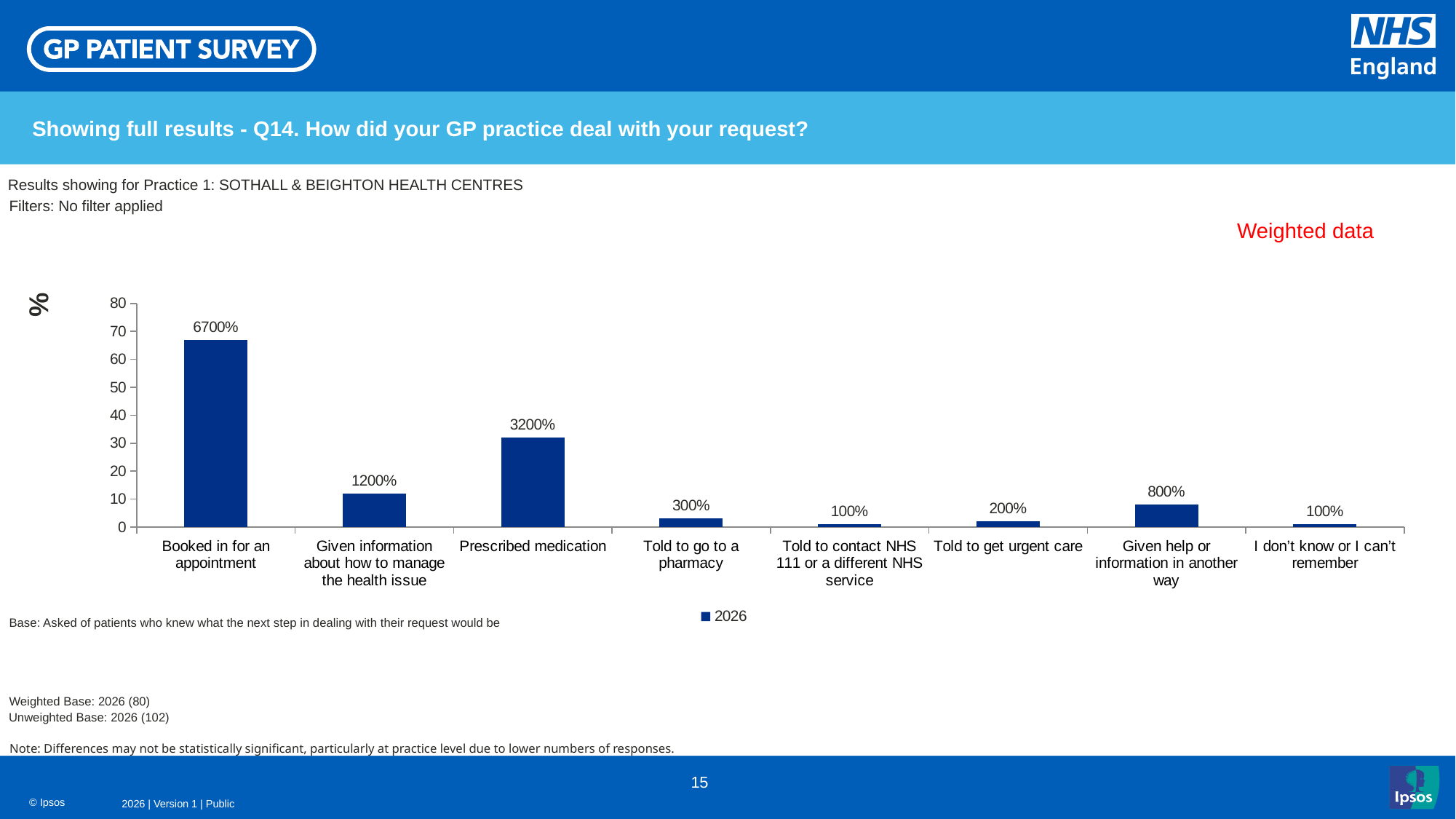
Is the bar for 'Prescribed medication' above or below the 40 mark on the y axis? below Which category has the highest bar? Booked in for an appointment What is the data label shown for 'Told to go to a pharmacy'? 300% How many categories are shown on the x axis? 8 What is the data label shown for 'Booked in for an appointment'? 6700% What is the data label shown for 'Prescribed medication'? 3200% What is the difference between the data labels for 'Booked in for an appointment' and 'Prescribed medication'? 3500% What kind of chart is shown on the slide? bar chart Which is larger: the value for 'Given information about how to manage the health issue' or the value for 'Given help or information in another way'? Given information about how to manage the health issue What is the data label shown for 'Given help or information in another way'? 800% What year does the legend entry show? 2026 How many series does the legend list? 1